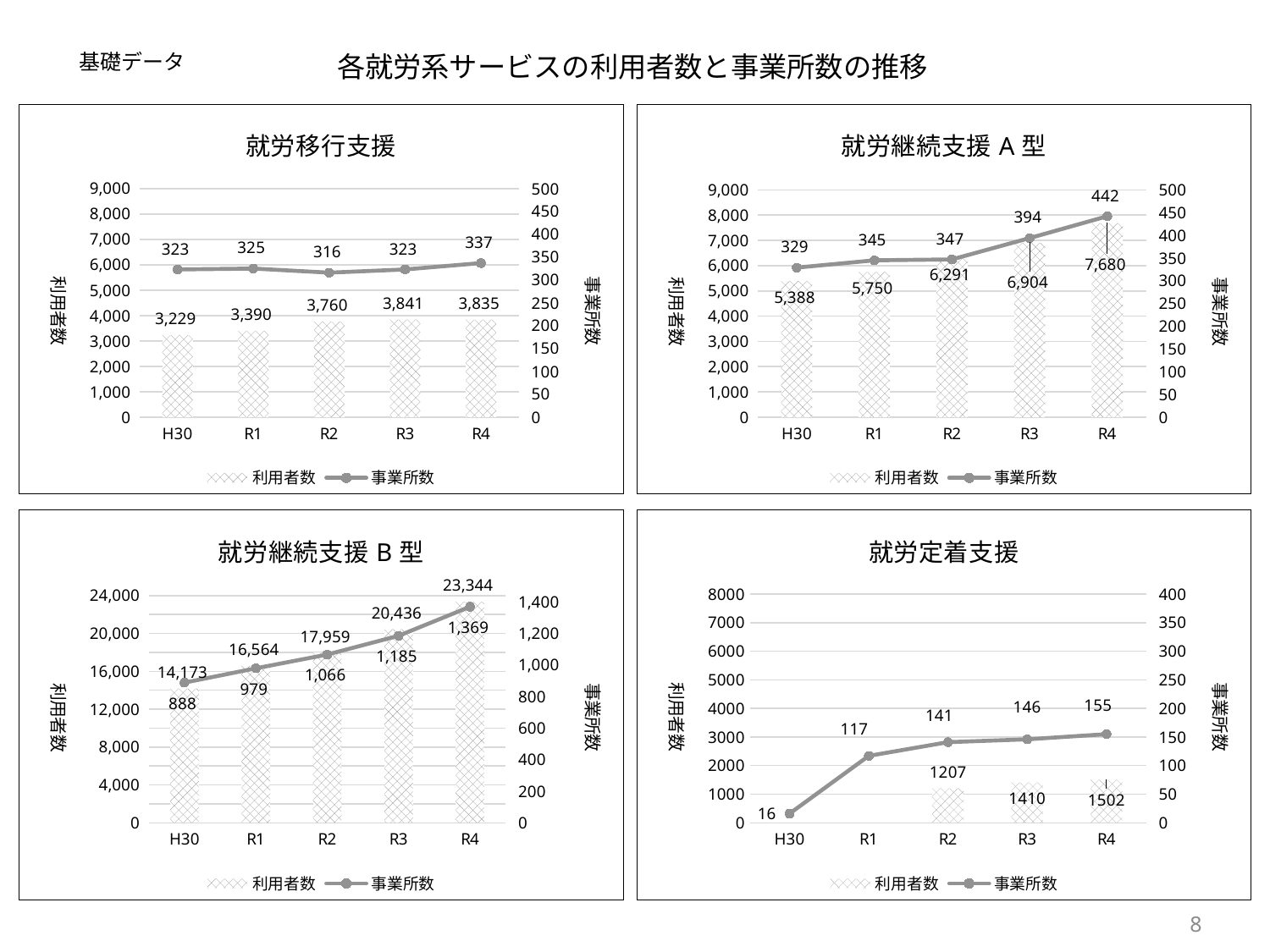
In the 就労継続支援Ａ型 chart, what is the 事業所数 value for R4? 442 In the 就労継続支援Ａ型 chart, does the 利用者数 rise or fall from H30 to R4? rise In the 就労定着支援 chart, which is larger, the 利用者数 for R3 or for R4? R4 In the 就労継続支援Ａ型 chart, what is the difference in 利用者数 between R4 and H30? 2,292 In the 就労移行支援 chart, which year has the lowest 事業所数? R2 How many years are shown on the x axis of the 就労継続支援Ａ型 chart? 5 How many series does the legend of the 就労移行支援 chart list? 2 In the 就労定着支援 chart, what is the 事業所数 value for H30? 16 In the 就労継続支援Ｂ型 chart, what is the difference in 事業所数 between R4 and R3? 184 In the 就労継続支援Ｂ型 chart, what is the 利用者数 value for R3? 20,436 In the 就労移行支援 chart, what is the 利用者数 value for R2? 3,760 In the 就労継続支援Ｂ型 chart, which year has the highest 事業所数? R4